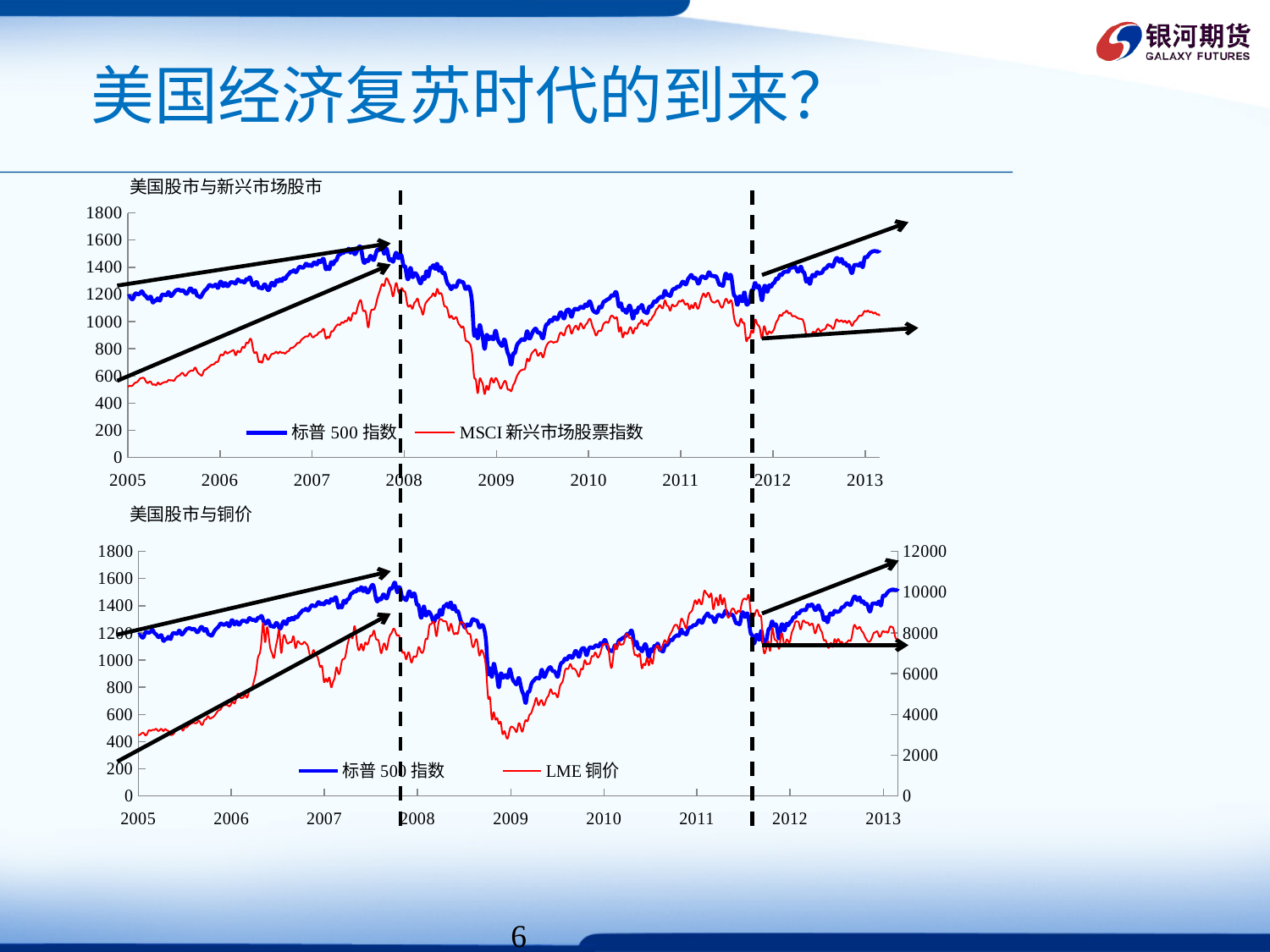
In the bottom chart (美国股市与铜价), is the peak value of LME 铜价 in 2011 greater or less than 8000 on the right axis? greater What is the title of the top chart on the slide? 美国股市与新兴市场股市 How many series does the legend of the top chart (美国股市与新兴市场股市) list? 2 In the top chart (美国股市与新兴市场股市), is the value of 标普 500 指数 at the end of the series in 2013 greater or less than 1400? greater In the bottom chart (美国股市与铜价), is the lowest value of LME 铜价 around early 2009 greater or less than 4000 on the right axis? less How many series does the legend of the bottom chart (美国股市与铜价) list? 2 In the top chart (美国股市与新兴市场股市), does 标普 500 指数 rise or fall from 2012 to 2013? rise In the bottom chart (美国股市与铜价), does 标普 500 指数 rise or fall from 2008 to early 2009? fall What kind of chart is the top chart titled 美国股市与新兴市场股市? line chart In the bottom chart (美国股市与铜价), which series is drawn in red? LME 铜价